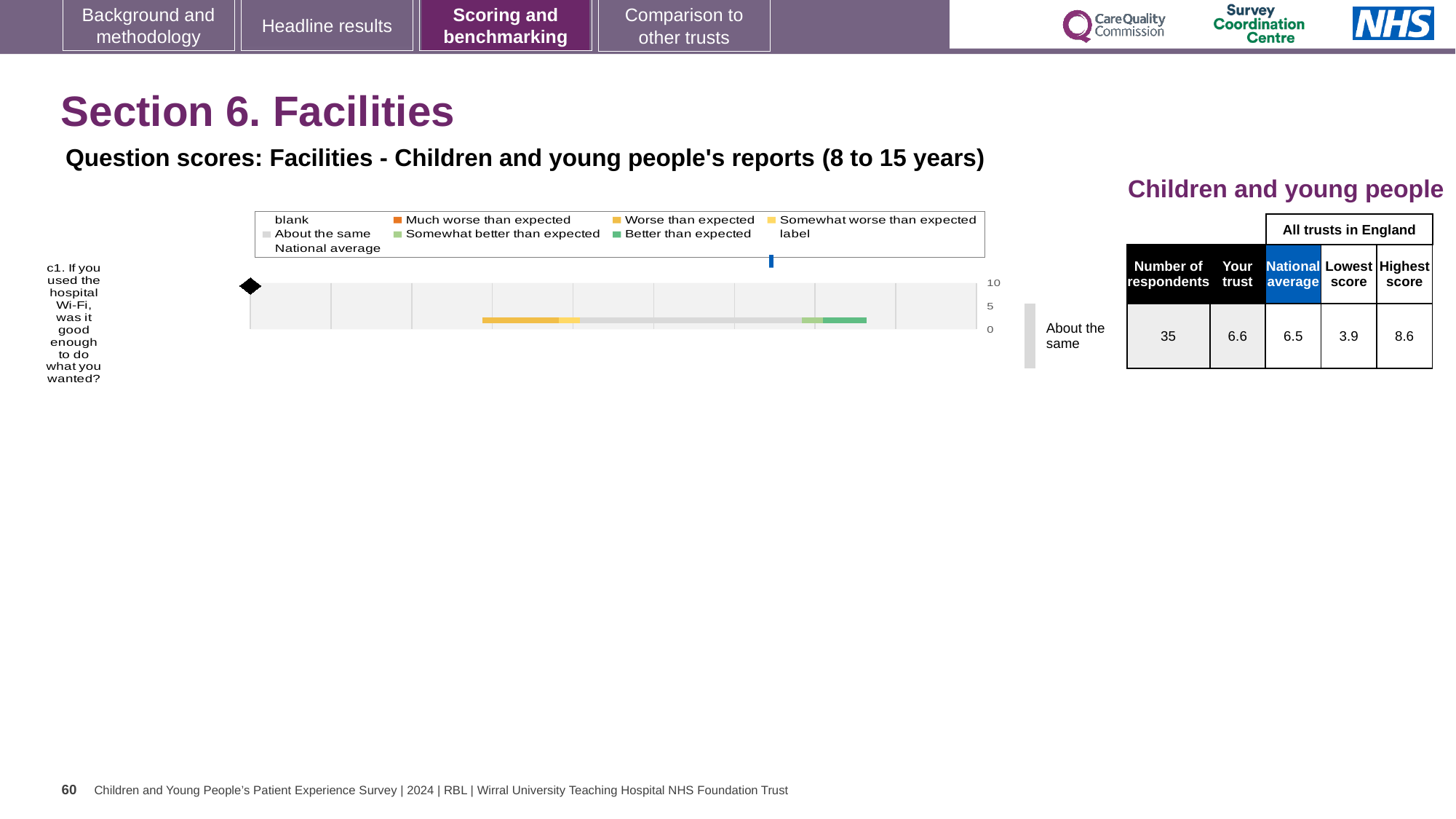
How many respondents answered question c1 about hospital Wi-Fi? 35 How many questions (categories) are plotted in the chart? 1 What is the highest tick value shown on the chart's axis? 10 Which is larger for question c1: the 'Your trust' score or the national average? Your trust According to the table beside the chart, what is the national average score for question c1 about hospital Wi-Fi? 6.5 What is the difference between the highest score and the lowest score for question c1? 4.7 According to the table beside the chart, what is the lowest score among all trusts in England for question c1? 3.9 What kind of chart is shown on the slide? bar chart What benchmark rating is given for question c1 about hospital Wi-Fi? About the same According to the table beside the chart, what is the 'Your trust' score for question c1 about hospital Wi-Fi? 6.6 What colour does the legend use for 'Better than expected'? green According to the table beside the chart, what is the highest score among all trusts in England for question c1? 8.6